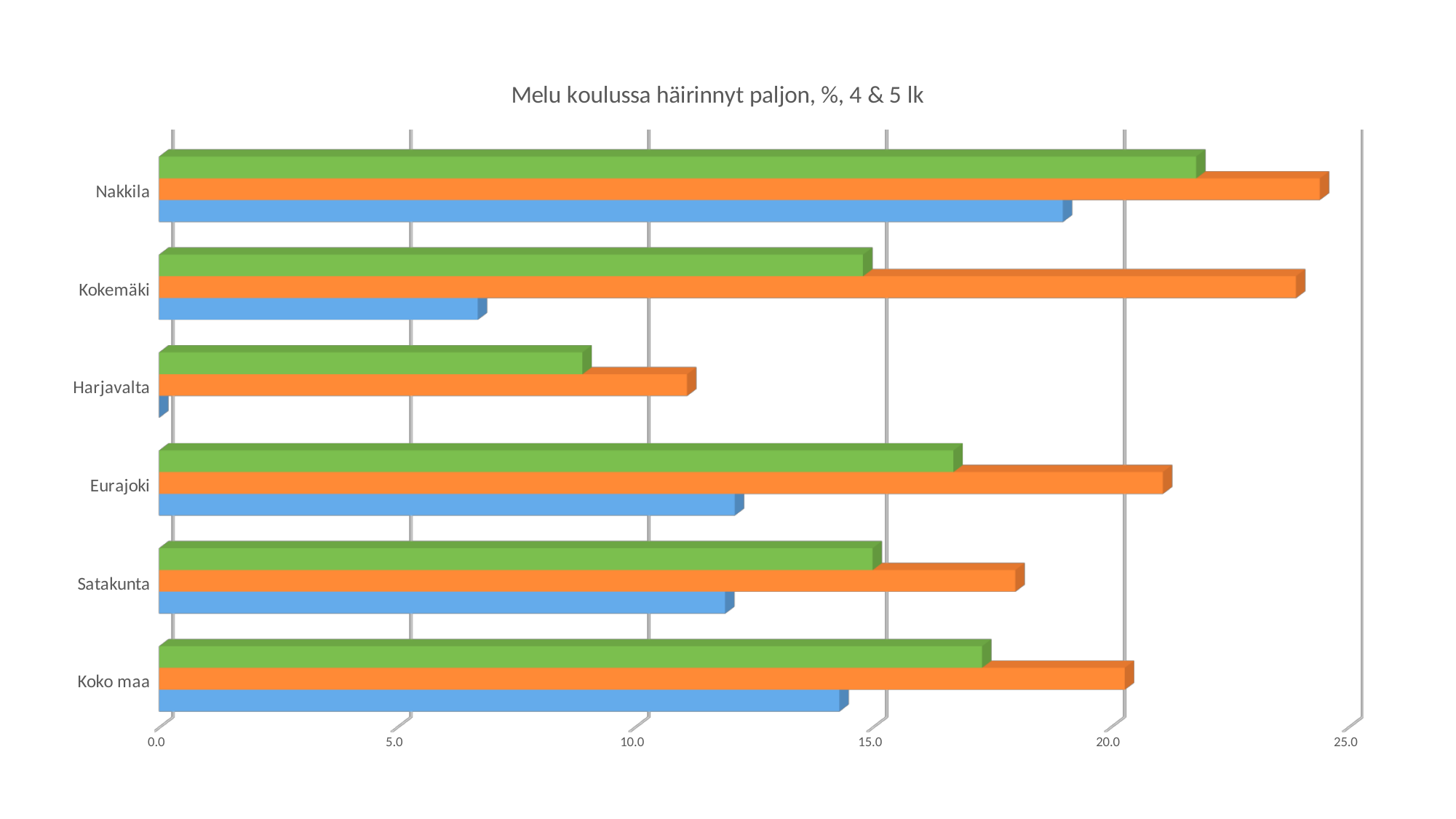
Is the value of the blue bar for Kokemäki greater or less than 10.0? less What is the title of the chart? Melu koulussa häirinnyt paljon, %, 4 & 5 lk Which category has the longest blue bar? Nakkila Which category has the shortest orange bar? Harjavalta Which category has the longest green bar? Nakkila How many bars are plotted for each category in the chart? 3 For Kokemäki, which is larger: the orange bar or the blue bar? the orange bar Is the value of the orange bar for Nakkila greater or less than 20.0? greater Which category has the shortest blue bar? Harjavalta Is the value of the green bar for Harjavalta greater or less than 10.0? less What kind of chart is shown on the slide? bar chart How many categories are shown on the vertical axis of the chart? 6